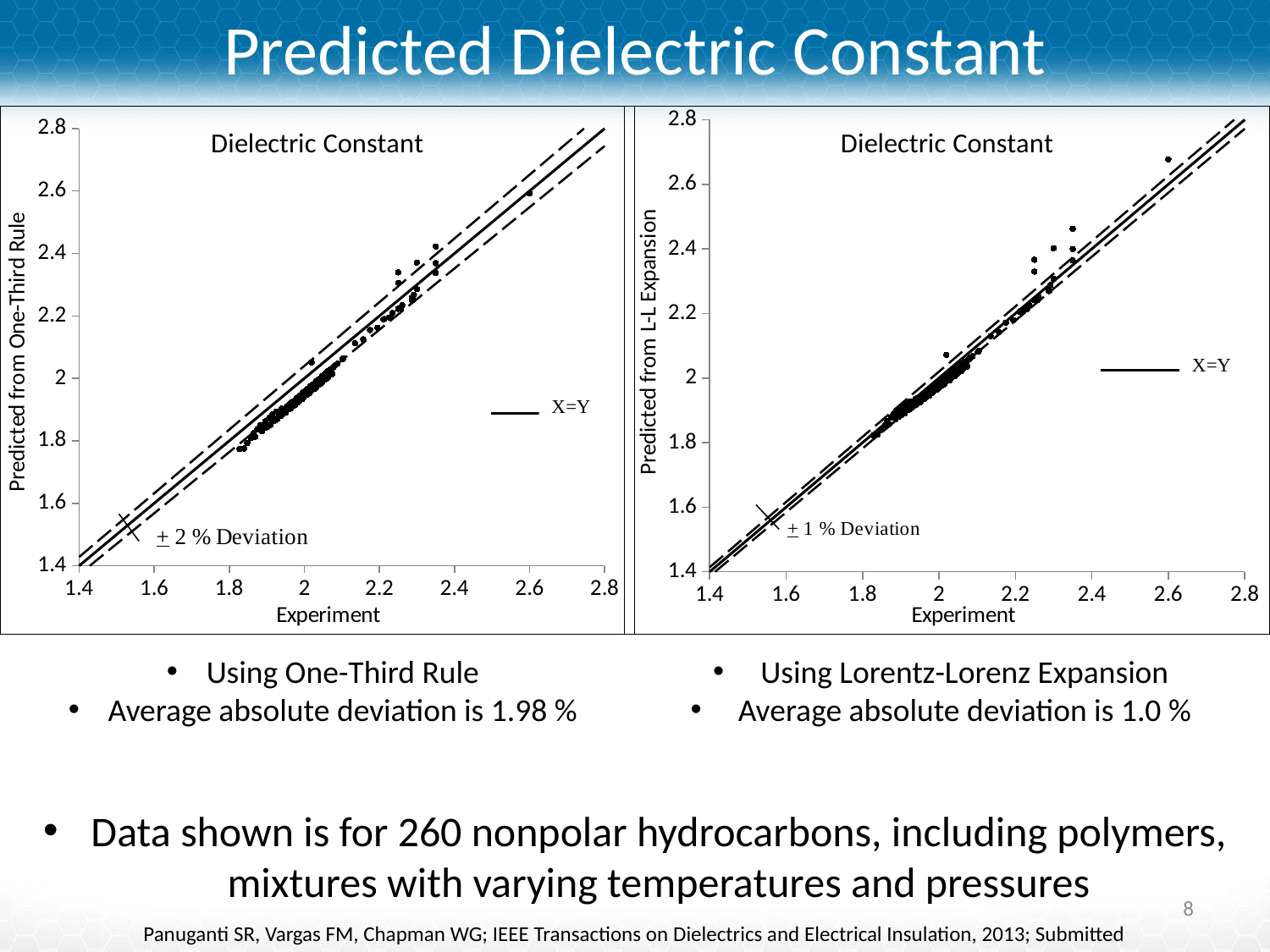
In the right chart, is the predicted value of the lowest plotted point greater or less than 2? less In the right chart, do the predicted values rise or fall as the experimental value increases along the x axis? rise What is the x-axis title of the left chart? Experiment In the left chart, do the predicted values rise or fall as the experimental value increases along the x axis? rise How many entries does the legend of the right chart list? 1 What is the y-axis title of the right chart? Predicted from L-L Expansion What kind of chart is the left chart on the slide? scatter chart In the left chart, is the predicted value of the lowest plotted point greater or less than 1.6? greater In the right chart, is the predicted value of the highest plotted point greater or less than 2.6? greater What is the y-axis title of the left chart? Predicted from One-Third Rule What kind of chart is the right chart on the slide? scatter chart